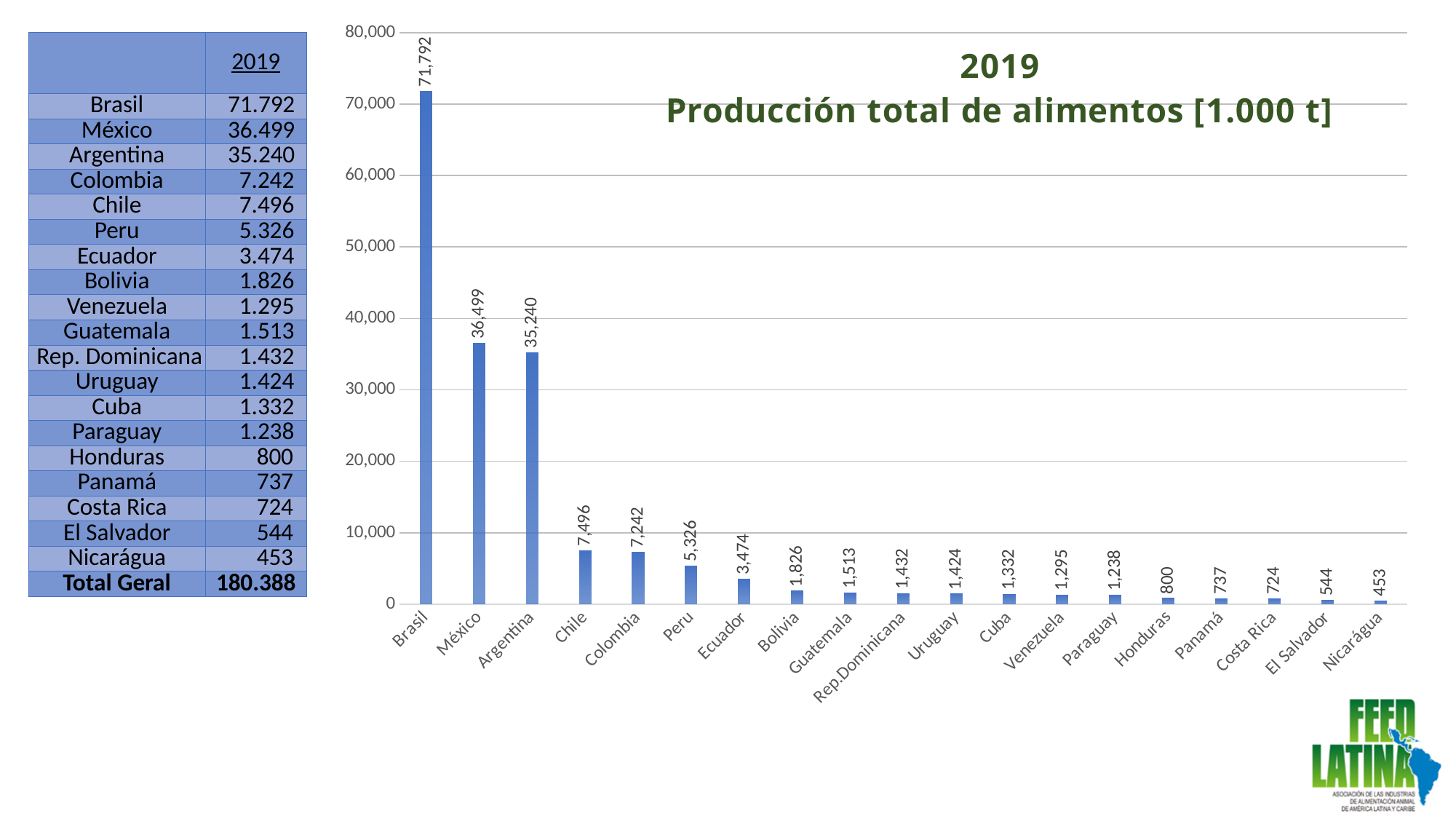
Which country has the lowest value in the chart? Nicarágua What is the value for Brasil in the chart? 71,792 Which country has the highest value in the chart? Brasil What is the value for Honduras in the chart? 800 What is the value for Argentina in the chart? 35,240 Is the value for Peru greater or less than 10,000? less Which is larger, the value for Chile or the value for Colombia? Chile What is the difference between the values for Chile and Colombia? 254 How many countries are shown in the chart? 19 What kind of chart is shown on the slide? bar chart What is the difference between the values for Brasil and México? 35,293 Do the values rise or fall from left to right along the x axis? fall